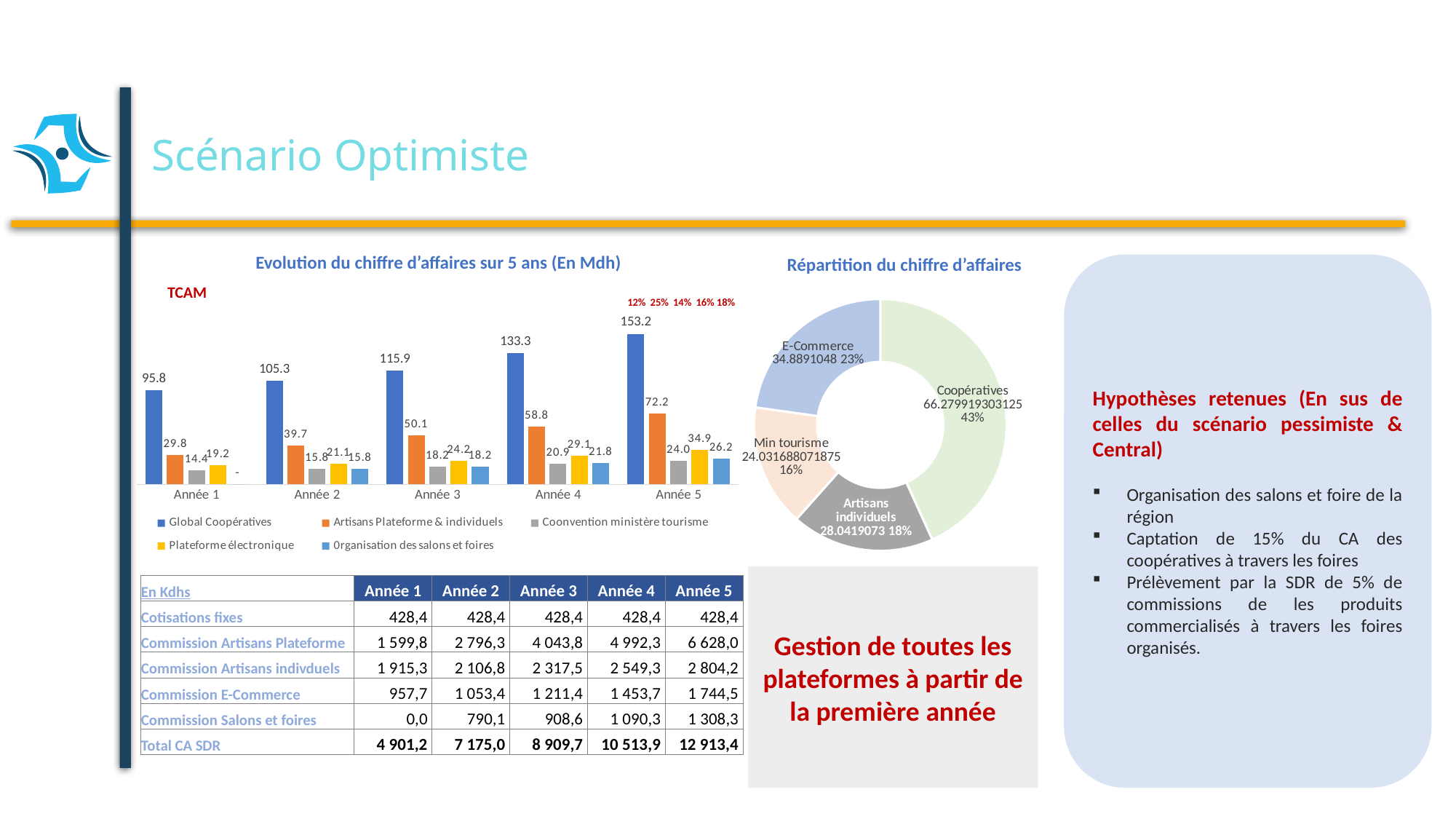
What kind of chart is 'Evolution du chiffre d'affaires sur 5 ans (En Mdh)'? bar chart In the chart 'Evolution du chiffre d'affaires sur 5 ans (En Mdh)', which is larger in Année 4: Plateforme électronique or Organisation des salons et foires? Plateforme électronique How many categories are shown in the chart 'Répartition du chiffre d'affaires'? 4 In the chart 'Evolution du chiffre d'affaires sur 5 ans (En Mdh)', do the Global Coopératives values rise or fall from Année 1 to Année 5? rise How many years are shown on the x axis of the chart 'Evolution du chiffre d'affaires sur 5 ans (En Mdh)'? 5 How many series does the legend of the chart 'Evolution du chiffre d'affaires sur 5 ans (En Mdh)' list? 5 In the chart 'Répartition du chiffre d'affaires', what share does Coopératives represent? 43% In the chart 'Evolution du chiffre d'affaires sur 5 ans (En Mdh)', what is the value for Artisans Plateforme & individuels in Année 3? 50.1 In the chart 'Evolution du chiffre d'affaires sur 5 ans (En Mdh)', what is the value for Global Coopératives in Année 5? 153.2 In the chart 'Evolution du chiffre d'affaires sur 5 ans (En Mdh)', what is the difference between the Global Coopératives values in Année 5 and Année 1? 57.4 In the chart 'Répartition du chiffre d'affaires', which category has the smallest share? Min tourisme In the chart 'Evolution du chiffre d'affaires sur 5 ans (En Mdh)', in which year is the Global Coopératives value highest? Année 5